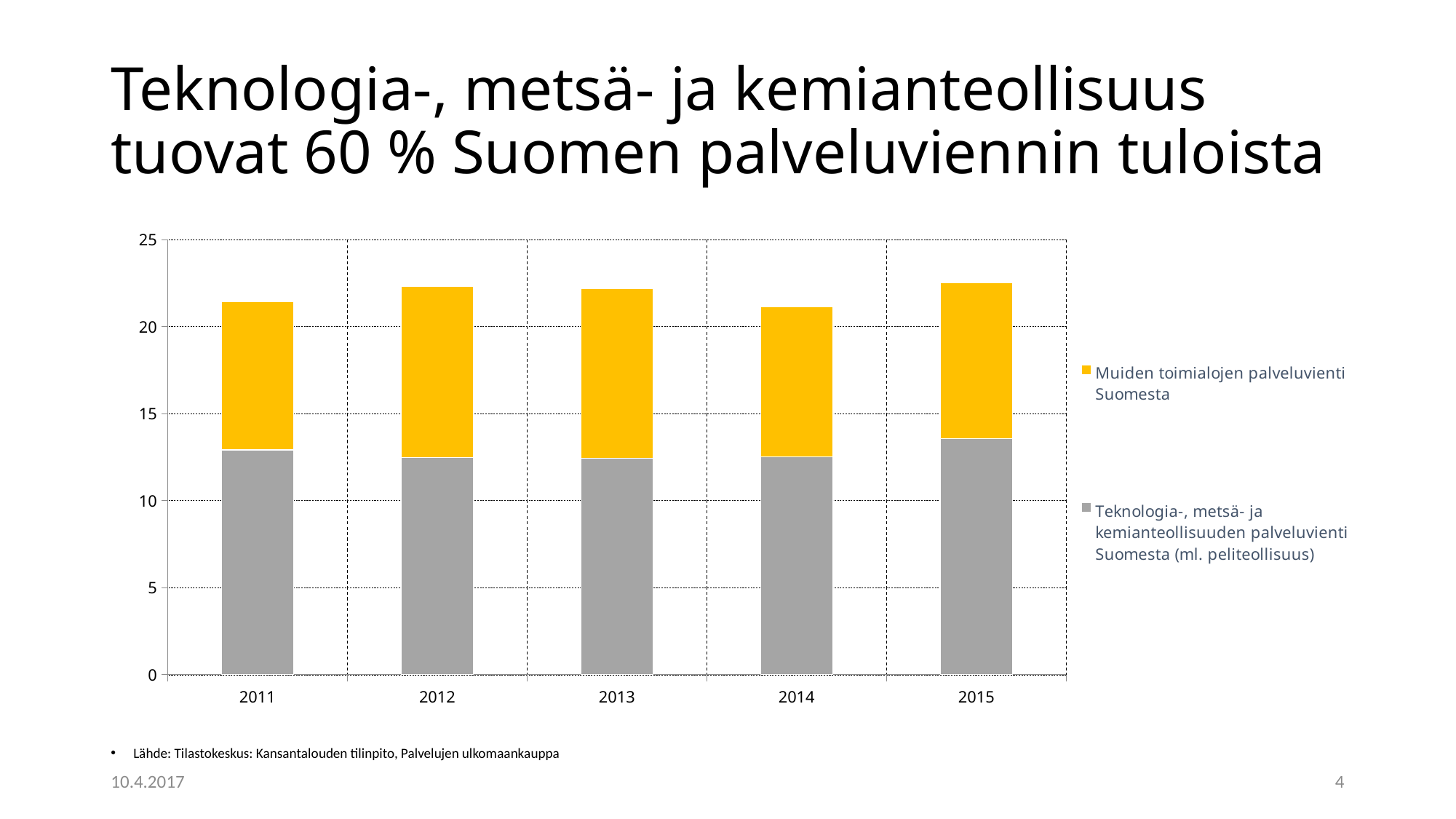
Which series is shown in yellow in the chart? Muiden toimialojen palveluvienti Suomesta How many series does the chart's legend list? 2 Is the value for 'Teknologia-, metsä- ja kemianteollisuuden palveluvienti Suomesta (ml. peliteollisuus)' in 2013 greater or less than 10? greater What kind of chart is shown on the slide? stacked bar chart Is the total height of the stacked bar for 2014 greater or less than 25? less Is the total stacked bar for 2015 taller or shorter than the total stacked bar for 2014? taller Is the value for 'Teknologia-, metsä- ja kemianteollisuuden palveluvienti Suomesta (ml. peliteollisuus)' in 2015 greater or less than 15? less How many years are shown on the x axis of the chart? 5 Which series is shown in grey in the chart? Teknologia-, metsä- ja kemianteollisuuden palveluvienti Suomesta (ml. peliteollisuus) Which year has the highest value for the series 'Teknologia-, metsä- ja kemianteollisuuden palveluvienti Suomesta (ml. peliteollisuus)'? 2015